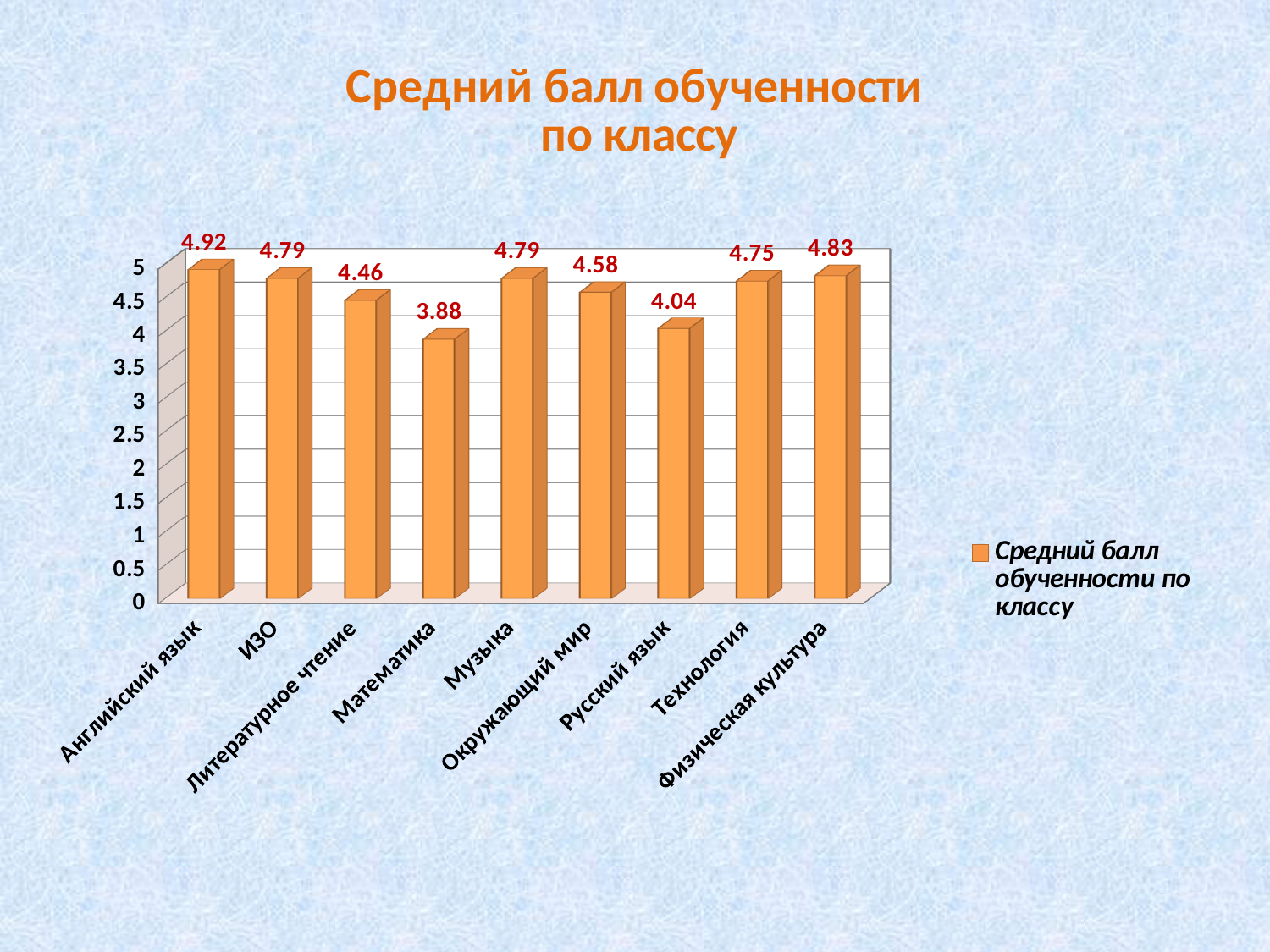
What is the value for Окружающий мир? 4.58 Is the value for Русский язык greater or less than 4.5? less What is the value for Математика? 3.88 What is the value for Физическая культура? 4.83 How many series does the legend list? 1 Which is larger, the value for Русский язык or the value for Литературное чтение? Литературное чтение What is the difference between the values for Английский язык and Математика? 1.04 Which category has the highest value? Английский язык How many categories are shown on the x axis? 9 What kind of chart is shown on the slide? bar chart Which category has the lowest value? Математика What is the title of the chart? Средний балл обученности по классу